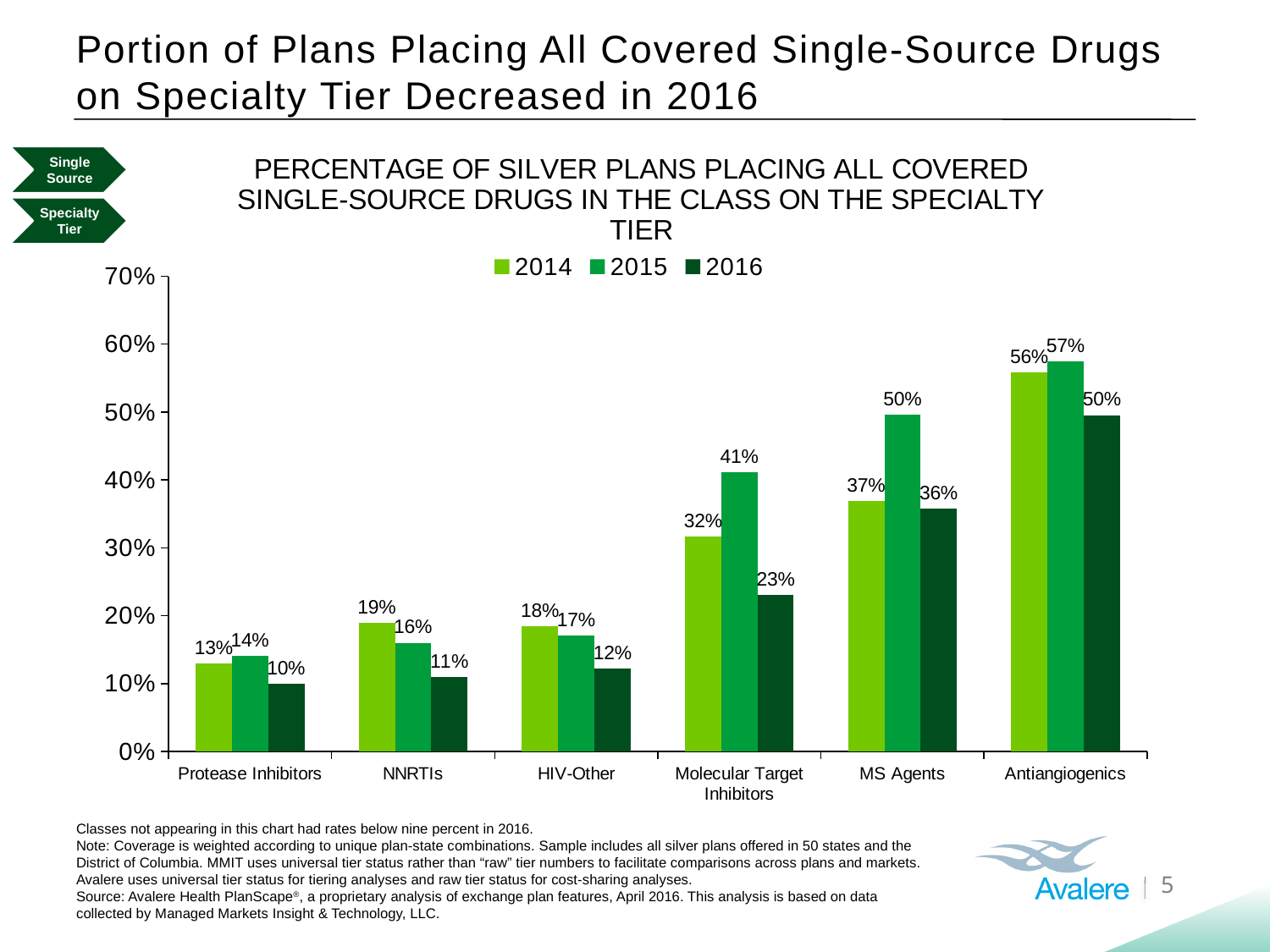
Which category has the highest 2016 value? Antiangiogenics What is the 2015 value for MS Agents? 50% Do the 2016 values rise or fall from Protease Inhibitors to Antiangiogenics? Rise What is the 2016 value for Molecular Target Inhibitors? 23% How many series does the legend list? 3 What is the 2014 value for NNRTIs? 19% Which category has the lowest 2016 value? Protease Inhibitors What is the difference between the 2015 and 2016 values for Molecular Target Inhibitors? 18% Which is larger for HIV-Other: the 2014 value or the 2015 value? 2014 Which years are listed in the chart legend? 2014, 2015, 2016 How many drug classes are shown on the x axis? 6 What kind of chart is shown on the slide? Bar chart